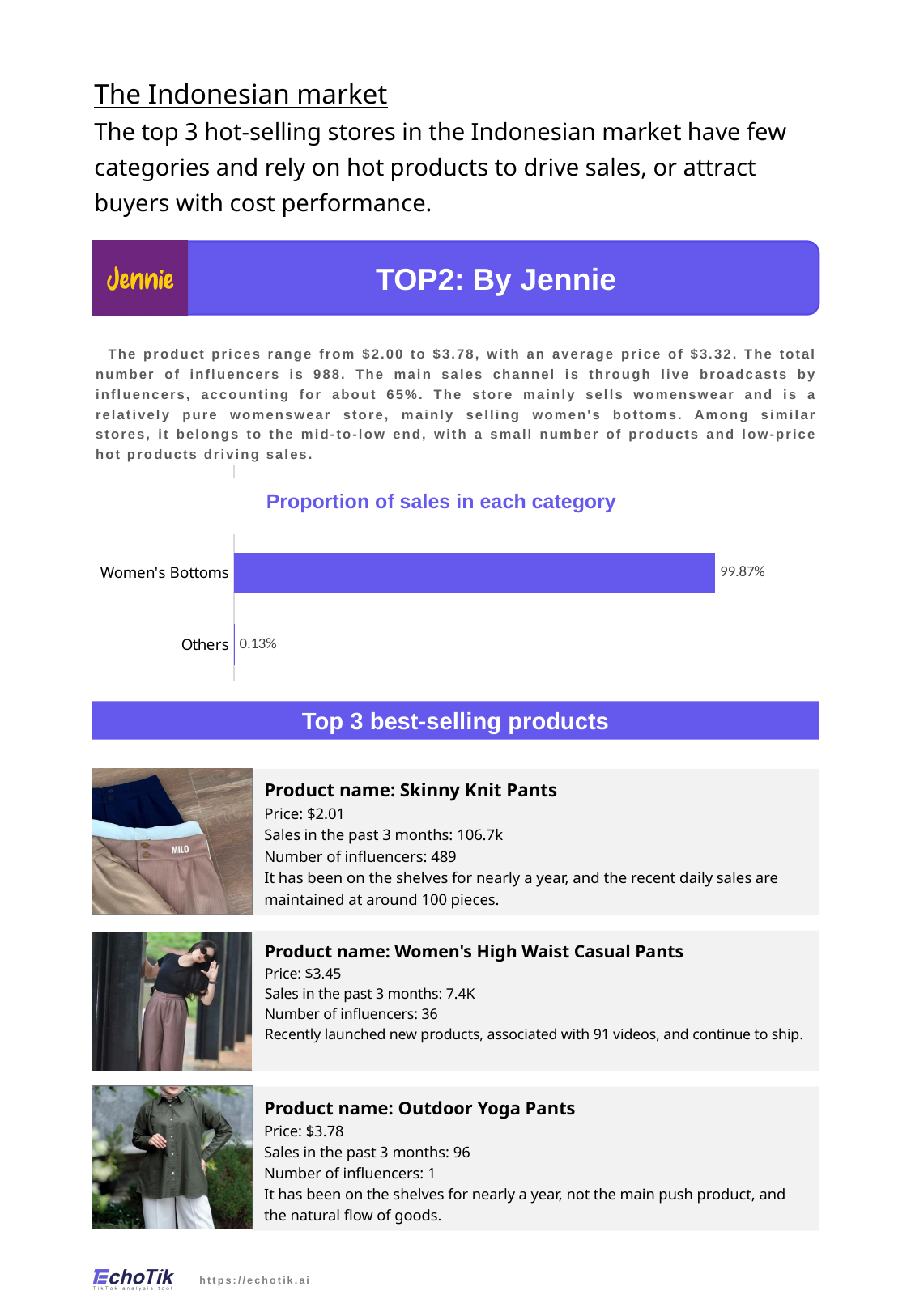
Which category has the highest proportion of sales in the chart? Women's Bottoms What is the total of the two values shown in the 'Proportion of sales in each category' chart? 100% Which category has the lowest proportion of sales in the chart? Others How many categories are shown in the 'Proportion of sales in each category' chart? 2 Which is larger in the chart: the value for Women's Bottoms or the value for Others? Women's Bottoms What is the value for Others in the 'Proportion of sales in each category' chart? 0.13% What is the title of the chart on the slide? Proportion of sales in each category What colour are the bars in the 'Proportion of sales in each category' chart? Purple What is the difference between the proportion of sales for Women's Bottoms and Others? 99.74% What is the value for Women's Bottoms in the 'Proportion of sales in each category' chart? 99.87% What kind of chart is used to show the proportion of sales in each category? Bar chart